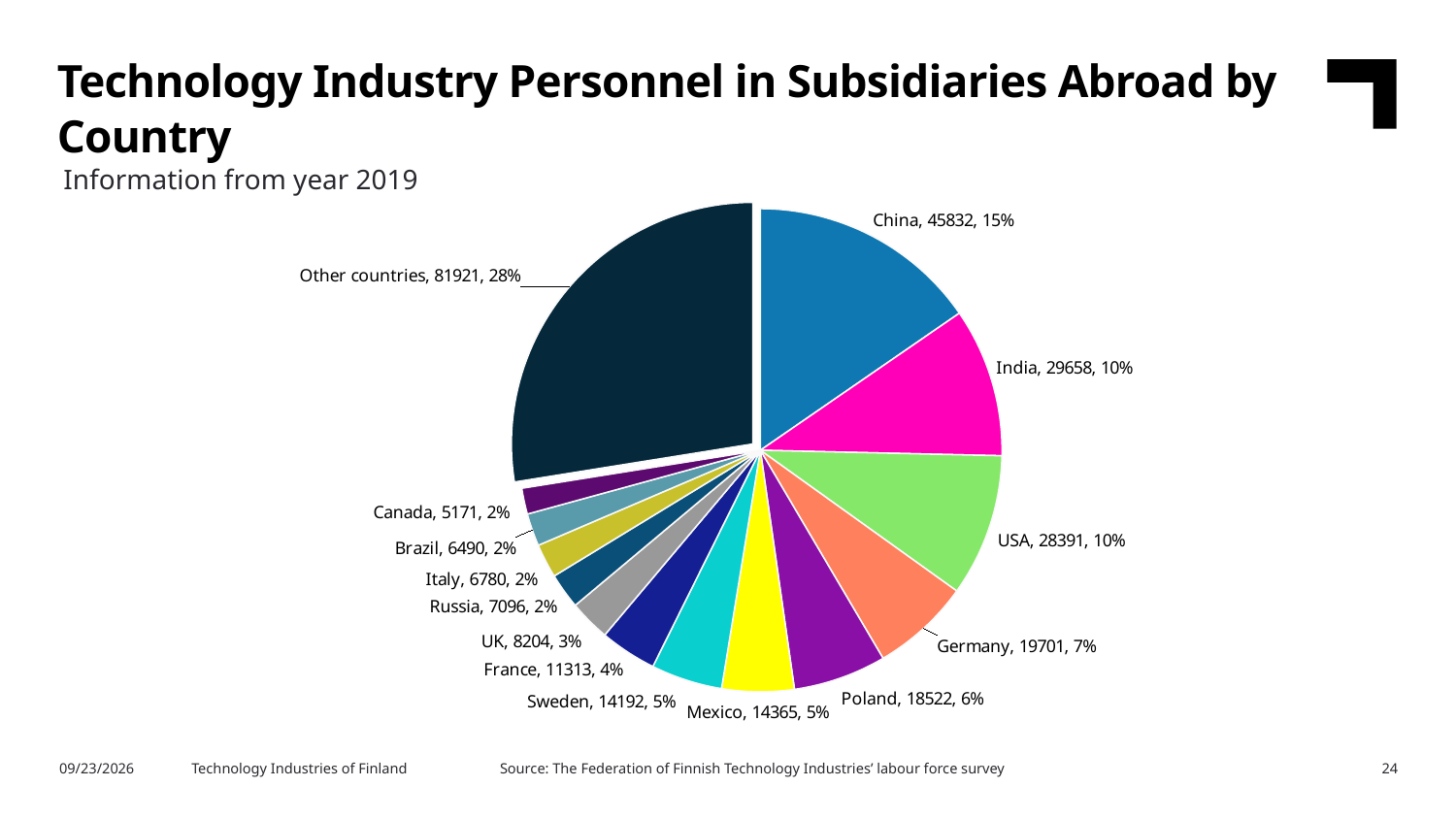
What is the title of the chart? Technology Industry Personnel in Subsidiaries Abroad by Country What is the value for China? 45832 What share of the pie does Other countries represent? 28% Which slice is the largest? Other countries What kind of chart is shown on the slide? pie chart What share of the pie does India represent? 10% How many slices does the pie chart have? 14 What is the value for Germany? 19701 Which country has the smallest slice? Canada Which is larger, the value for Poland or the value for Mexico? Poland What is the difference between the values for China and India? 16174 What is the value for Sweden? 14192